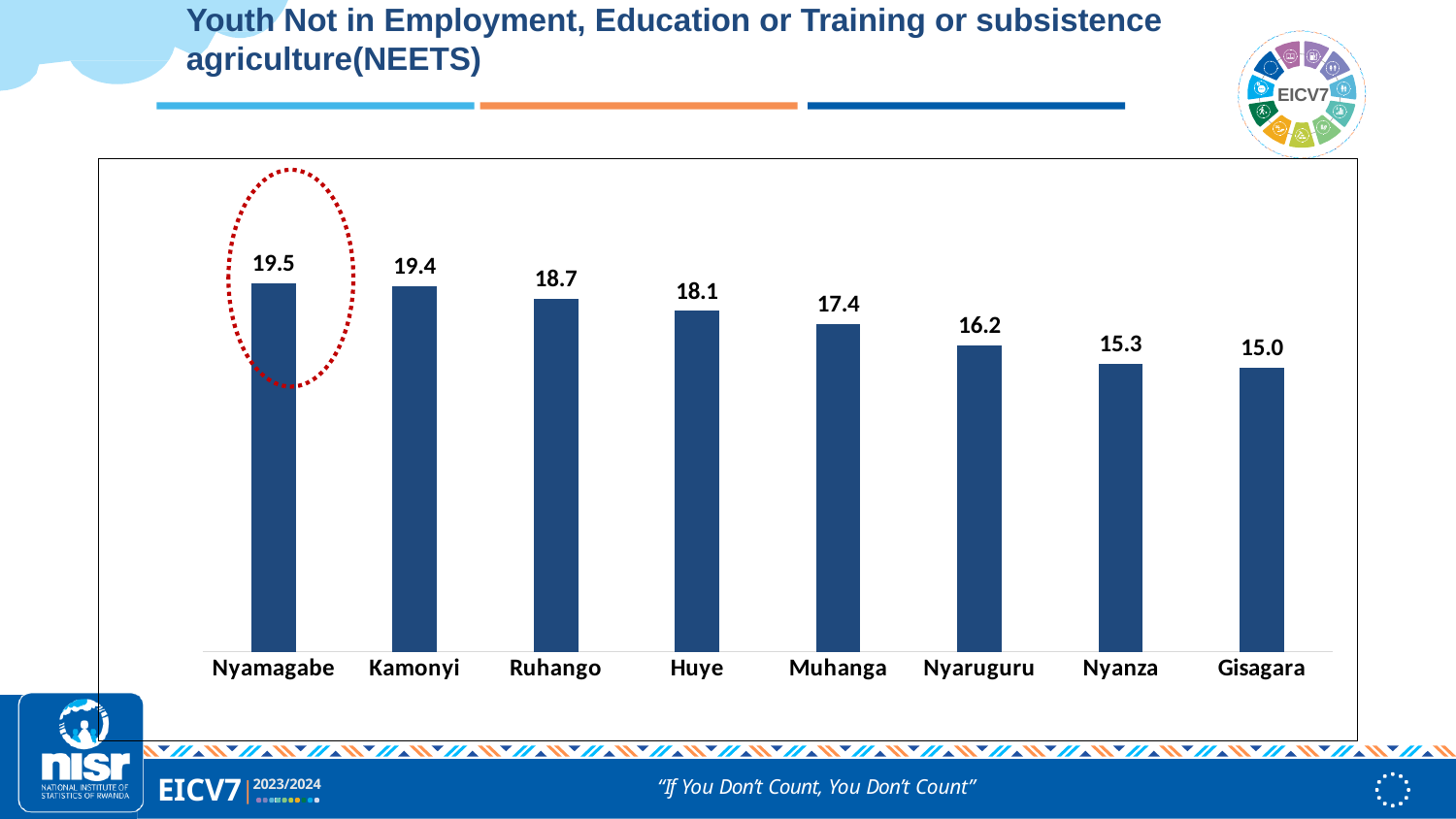
What kind of chart is shown on the slide? Bar chart Which has a higher NEETS value, Huye or Nyanza? Huye What is the NEETS value for Gisagara? 15.0 Which district has the highest NEETS value? Nyamagabe What is the difference between the NEETS values for Nyamagabe and Gisagara? 4.5 How many districts are shown in the chart? 8 Do the values rise or fall from left to right across the districts? Fall What is the NEETS value for Nyamagabe? 19.5 What is the difference between the NEETS values for Ruhango and Nyaruguru? 2.5 Which district has the lowest NEETS value? Gisagara Which district's bar is circled with a red dotted outline? Nyamagabe What is the NEETS value for Muhanga? 17.4